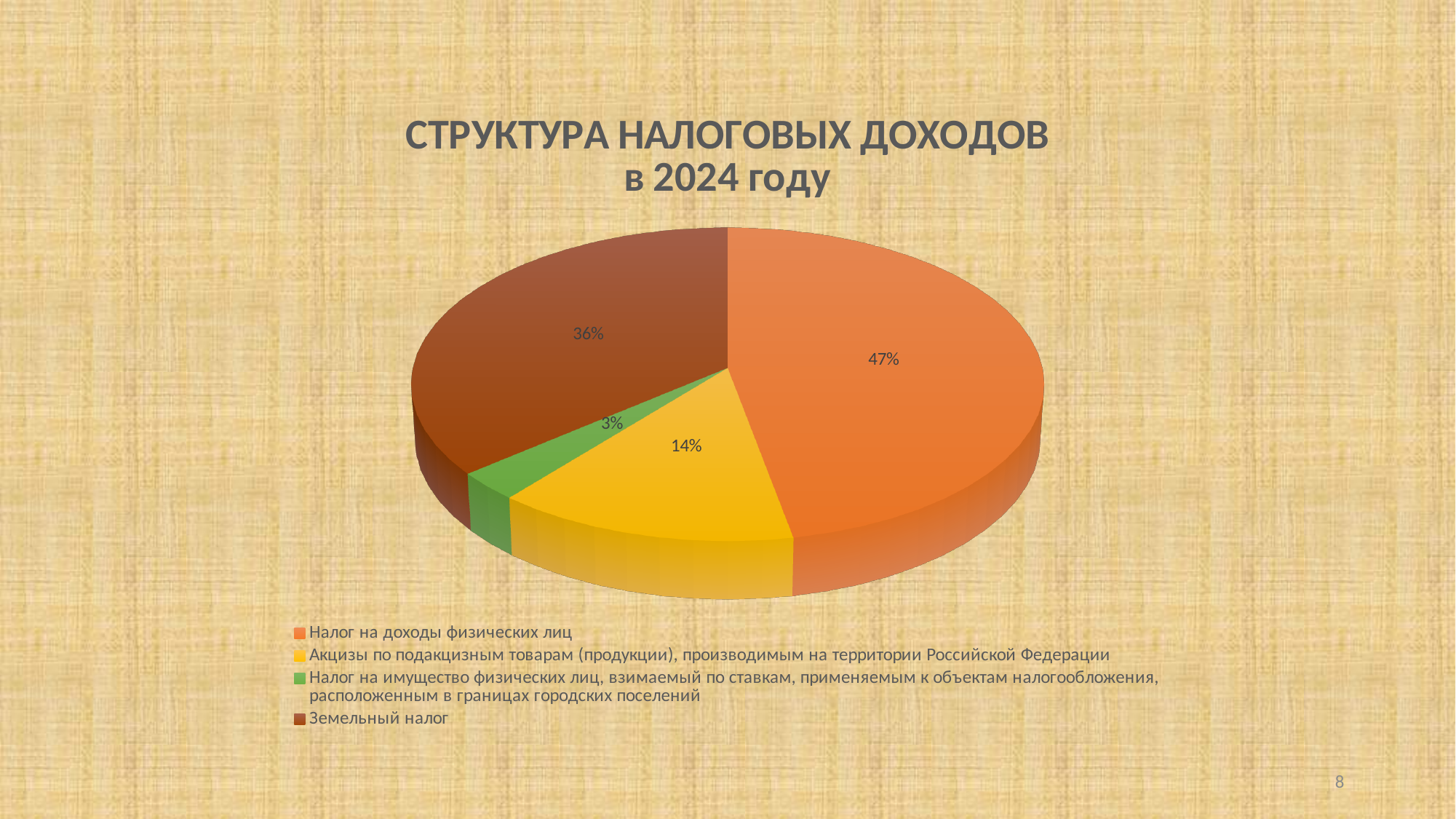
Which category has the largest share of the pie? Налог на доходы физических лиц What colour is the slice for "Земельный налог"? Brown How many categories are shown in the pie chart? 4 What share of the pie does "Налог на доходы физических лиц" represent? 47% What share of the pie does "Налог на имущество физических лиц" represent? 3% What kind of chart is shown on the slide? Pie chart What is the difference in percentage points between the share of "Налог на доходы физических лиц" and the share of "Земельный налог"? 11 What share of the pie does "Акцизы по подакцизным товарам (продукции), производимым на территории Российской Федерации" represent? 14% Which category has the smallest share of the pie? Налог на имущество физических лиц, взимаемый по ставкам, применяемым к объектам налогообложения, расположенным в границах городских поселений Which is larger: the share of "Земельный налог" or the share of "Акцизы по подакцизным товарам"? Земельный налог What is the title of the chart? СТРУКТУРА НАЛОГОВЫХ ДОХОДОВ в 2024 году